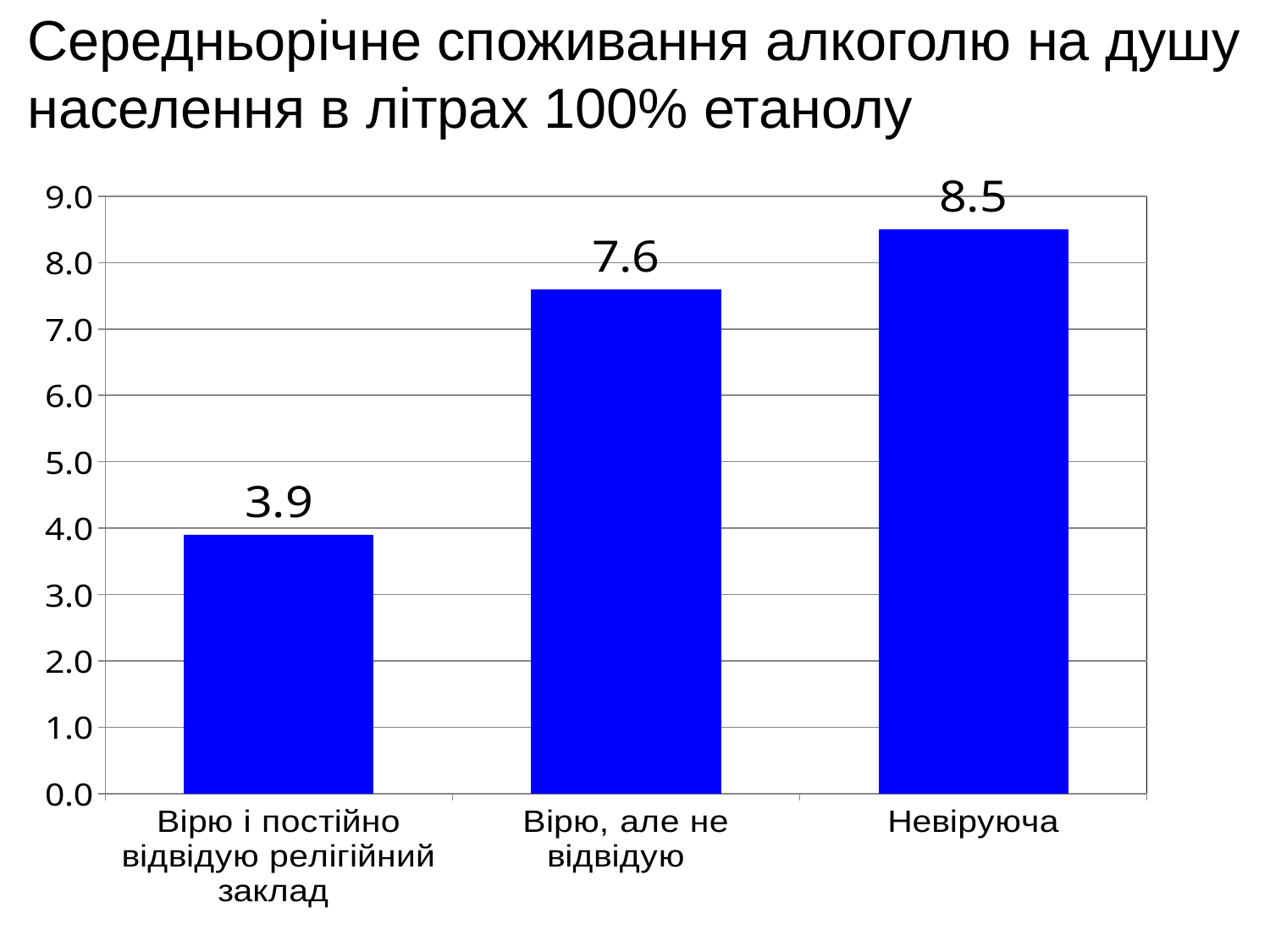
What is the difference between the values for "Невіруюча" and "Вірю, але не відвідую"? 0.9 What is the value for "Невіруюча"? 8.5 What is the value for "Вірю, але не відвідую"? 7.6 What is the difference between the values for "Невіруюча" and "Вірю і постійно відвідую релігійний заклад"? 4.6 Which category has the highest value? Невіруюча Is the value for "Вірю, але не відвідую" greater or less than 7.0? greater Do the values rise or fall from left to right across the categories? rise Which is larger: the value for "Вірю, але не відвідую" or for "Вірю і постійно відвідую релігійний заклад"? Вірю, але не відвідую How many categories are shown on the chart? 3 What is the value for "Вірю і постійно відвідую релігійний заклад"? 3.9 Which category has the lowest value? Вірю і постійно відвідую релігійний заклад What kind of chart is shown on the slide? bar chart